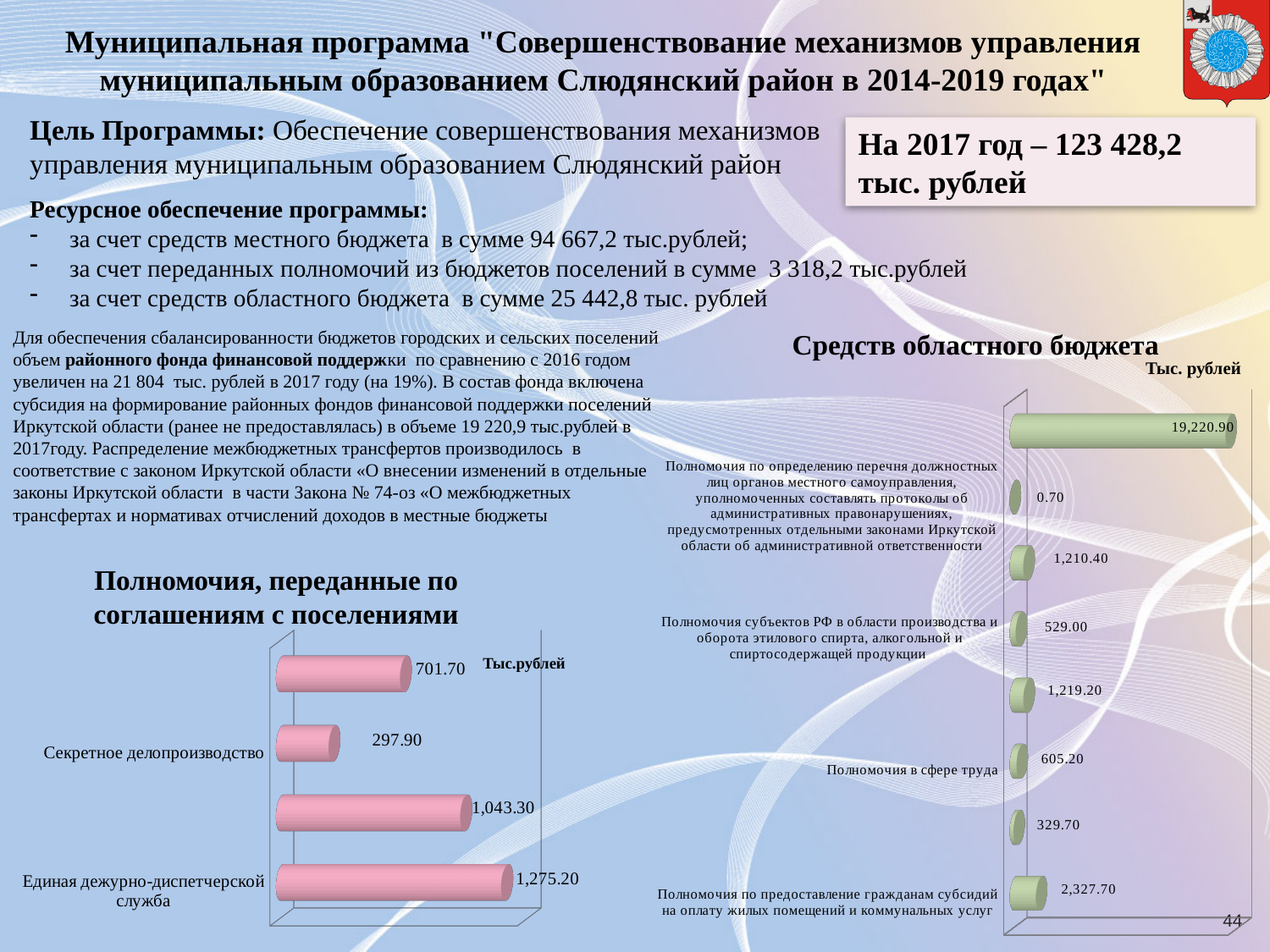
On the chart "Средств областного бюджета", what is the value for Полномочия субъектов РФ в области производства и оборота этилового спирта, алкогольной и спиртосодержащей продукции? 529.00 What kind of chart is "Полномочия, переданные по соглашениям с поселениями"? bar chart On the chart "Средств областного бюджета", which is larger: the value for Полномочия в сфере труда or the value for Полномочия субъектов РФ в области производства и оборота этилового спирта? Полномочия в сфере труда On the chart "Средств областного бюджета", what is the value for Полномочия в сфере труда? 605.20 On the chart "Средств областного бюджета", what is the largest value shown? 19,220.90 On the chart "Полномочия, переданные по соглашениям с поселениями", what is the difference between the value for Единая дежурно-диспетчерская служба and the value for Секретное делопроизводство? 977.30 On the chart "Полномочия, переданные по соглашениям с поселениями", what is the value for Секретное делопроизводство? 297.90 On the chart "Средств областного бюджета", what is the smallest value shown? 0.70 On the chart "Полномочия, переданные по соглашениям с поселениями", what is the largest value shown? 1,275.20 On the chart "Средств областного бюджета", what is the value for Полномочия по предоставлению гражданам субсидий на оплату жилых помещений и коммунальных услуг? 2,327.70 On the chart "Полномочия, переданные по соглашениям с поселениями", how many bars are plotted? 4 On the chart "Полномочия, переданные по соглашениям с поселениями", what is the value for Единая дежурно-диспетчерская служба? 1,275.20